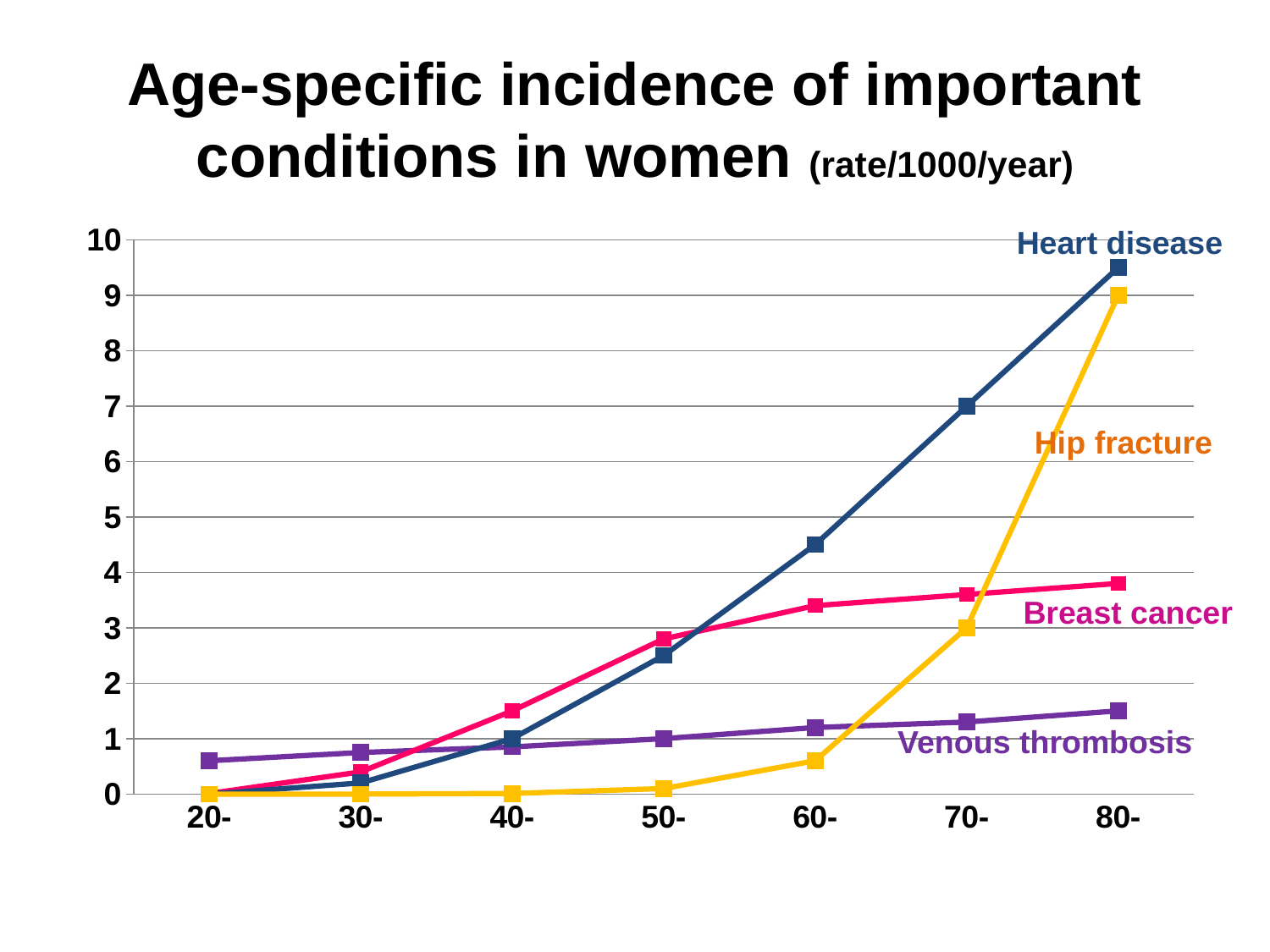
Which condition has the highest incidence in the 80- age group? Heart disease What is the incidence rate of hip fracture in the 70- age group? 3 What is the incidence rate of hip fracture in the 80- age group? 9 What is the incidence rate of venous thrombosis in the 50- age group? 1 How many conditions (series) are plotted on the chart? 4 Which condition has the lowest incidence in the 80- age group? Venous thrombosis Is the heart disease rate in the 80- age group greater or less than 9? greater What kind of chart is shown on the slide? line chart How many age groups are shown on the x axis? 7 In the 60- age group, which is higher: heart disease or breast cancer? Heart disease By how much does the hip fracture rate increase from the 70- to the 80- age group? 6 What is the incidence rate of heart disease in the 70- age group? 7